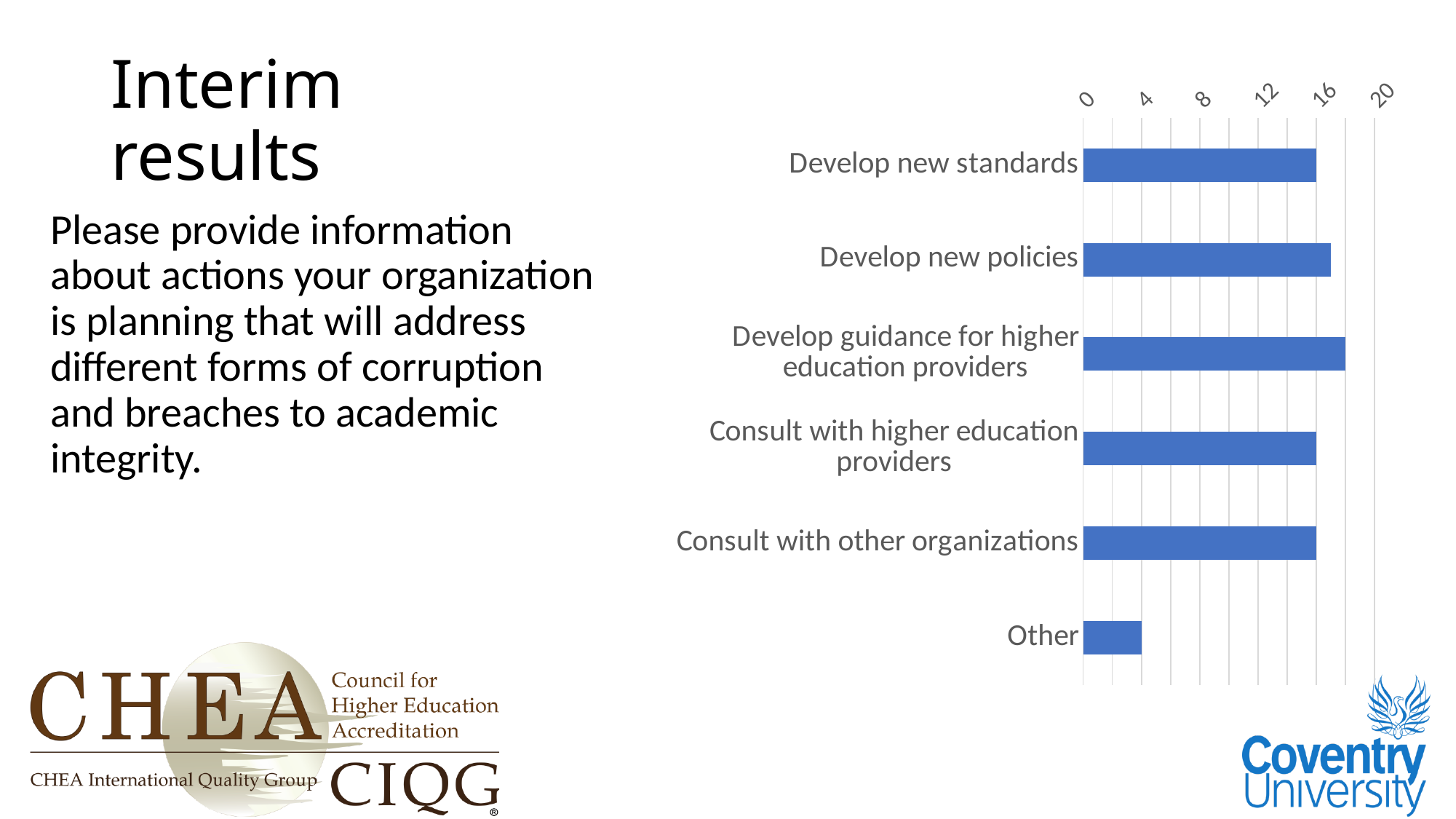
What is the value for Consult with other organizations? 16 What is the difference between the value for Develop new standards and the value for Other? 12 Which category has the lowest value in the bar chart? Other Which category has the highest value in the bar chart? Develop guidance for higher education providers Is the value for Other greater or less than 8? less What kind of chart is shown on the slide? bar chart What is the value for Other? 4 Is the value for Develop new policies greater or less than 12? greater Is the value for Develop guidance for higher education providers greater or less than 16? greater Which is larger, the value for Develop new standards or the value for Other? Develop new standards How many categories are shown in the bar chart? 6 What is the value for Develop new standards? 16